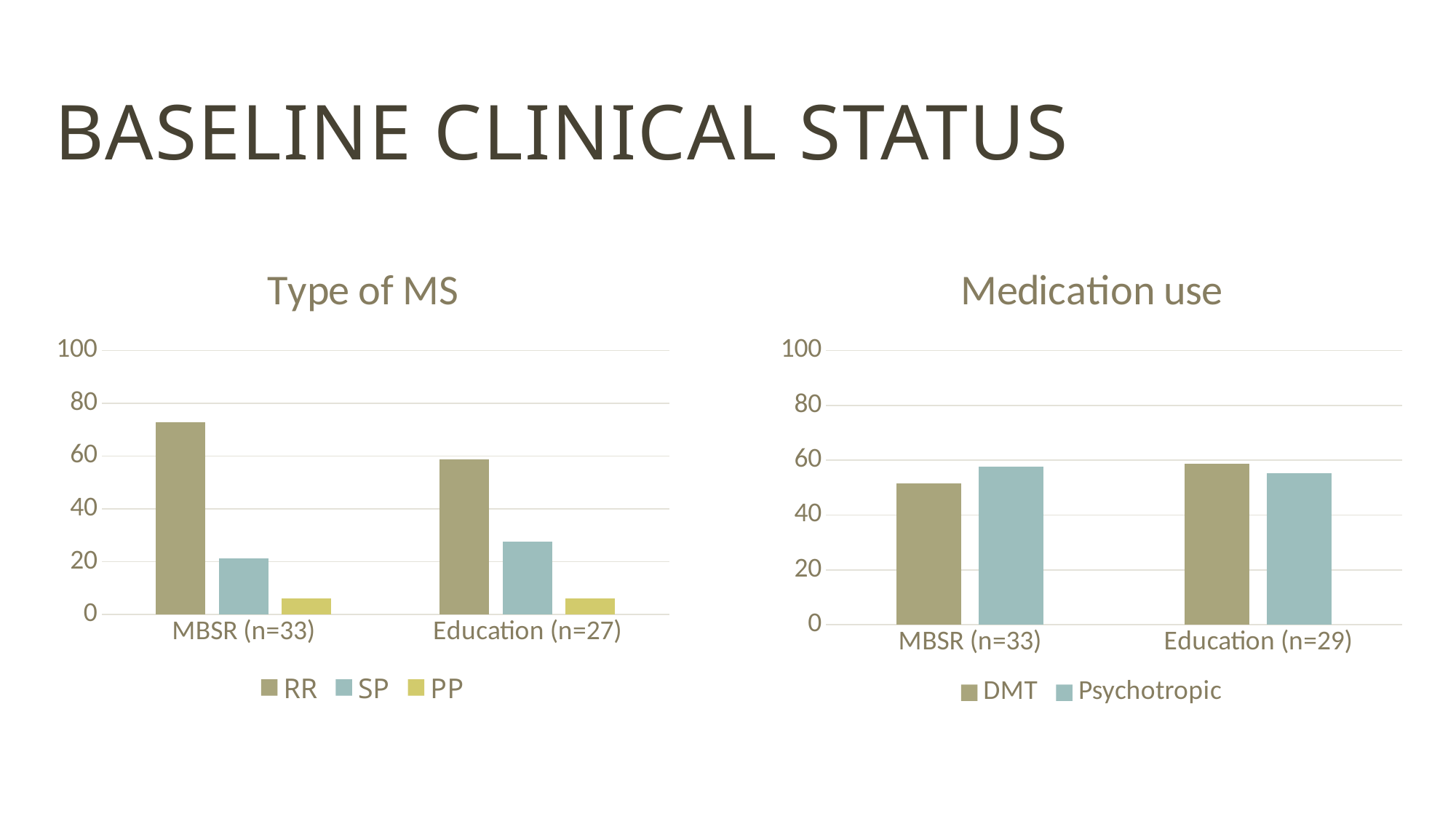
In the 'Type of MS' chart, how many series does the legend list? 3 In the 'Type of MS' chart, is the SP value for Education (n=27) greater or less than 40? less In the 'Type of MS' chart, which series has the lowest value for Education (n=27)? PP In the 'Type of MS' chart, what kind of chart is shown? bar chart In the 'Medication use' chart, how many groups are shown on the x axis? 2 In the 'Medication use' chart, which series has the larger value for MBSR (n=33), DMT or Psychotropic? Psychotropic In the 'Type of MS' chart, is the RR value for MBSR (n=33) greater or less than 60? greater In the 'Medication use' chart, is the DMT value for MBSR (n=33) greater or less than 60? less In the 'Medication use' chart, how many series does the legend list? 2 In the 'Type of MS' chart, which series has the highest value for MBSR (n=33)? RR In the 'Type of MS' chart, which group has the larger RR value, MBSR (n=33) or Education (n=27)? MBSR (n=33) In the 'Medication use' chart, what are the legend entries? DMT, Psychotropic